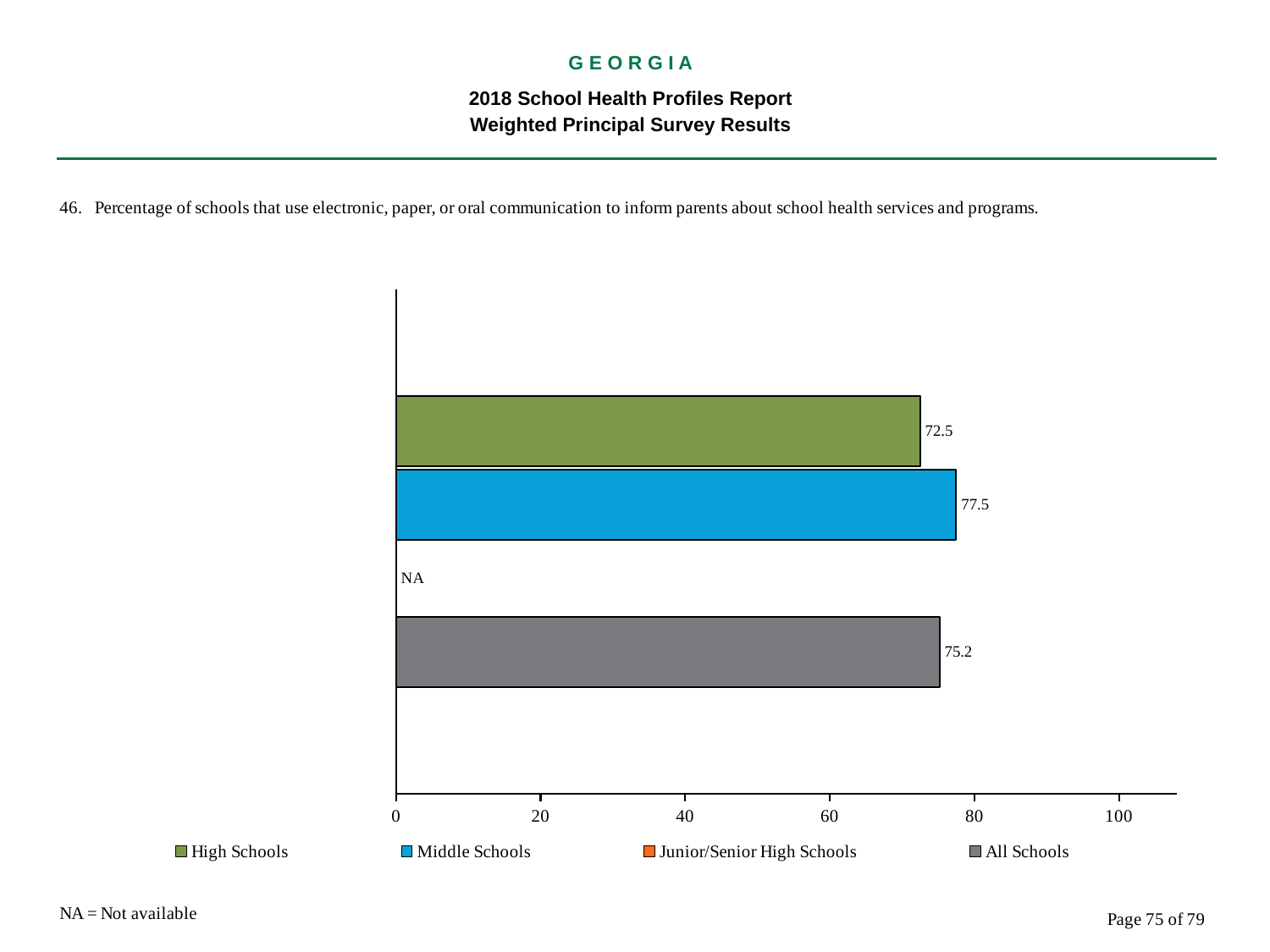
What is the difference between the Middle Schools value and the High Schools value? 5.0 What does NA stand for according to the note on the slide? Not available What kind of chart is this? bar chart Which school type has the highest value? Middle Schools Which is larger, the value for All Schools or the value for High Schools? All Schools What is the value for Middle Schools? 77.5 Is the value for Middle Schools greater or less than 80? less What is the value for All Schools? 75.2 What is the value for High Schools? 72.5 How many series does the legend list? 4 Which school type with a plotted value has the lowest value? High Schools What is shown for Junior/Senior High Schools? NA